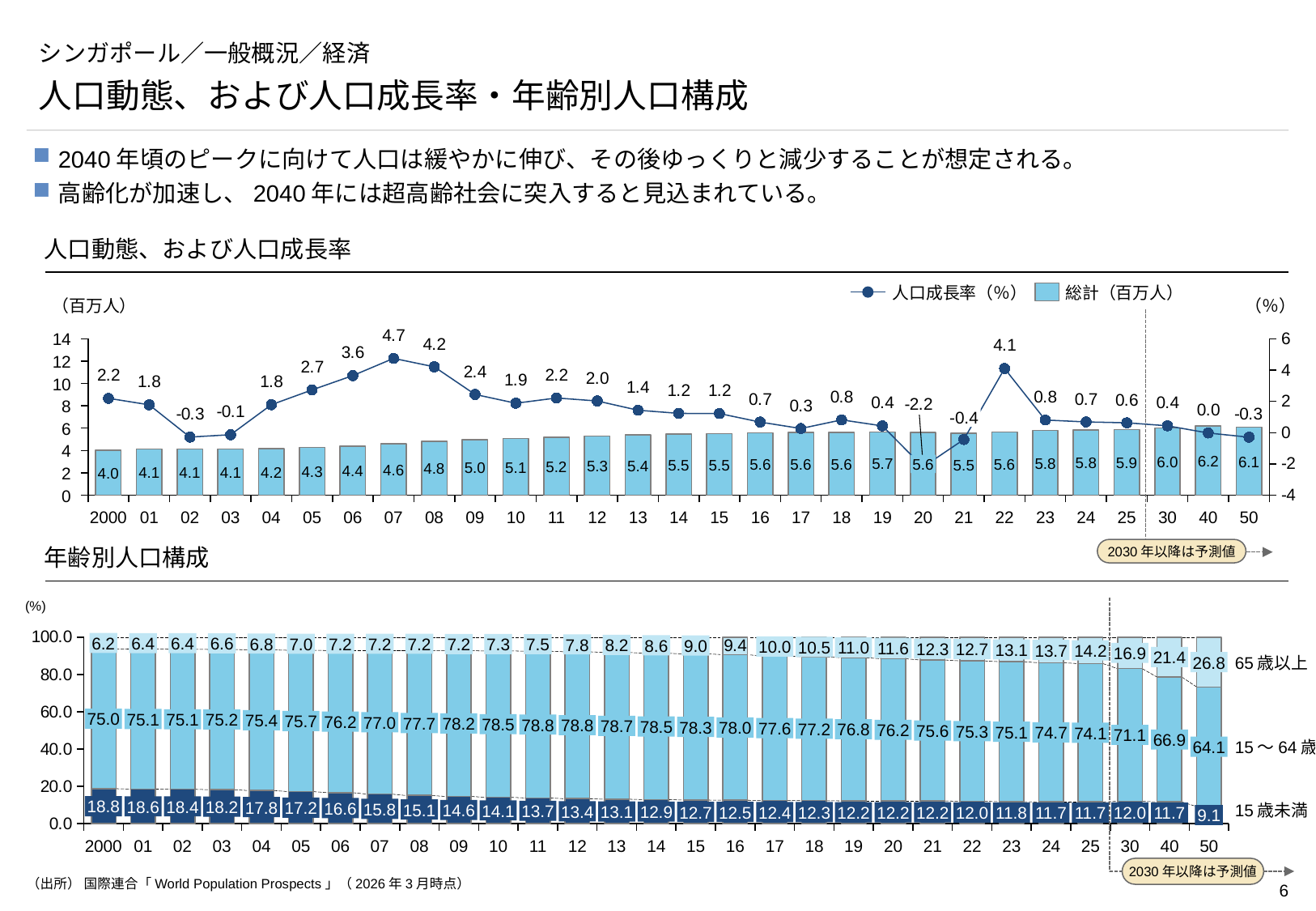
「人口動態、および人口成長率」のグラフで、2040年の総計（百万人）はいくつですか？ 6.2 「年齢別人口構成」のグラフで、15～64歳の割合が最も高い年はどれですか？ 2011年と2012年 「人口動態、および人口成長率」のグラフで、人口成長率が最も高い年はどれですか？ 2007年 「人口動態、および人口成長率」のグラフで、人口成長率が最も低い年はどれですか？ 2020年 「年齢別人口構成」のグラフで、65歳以上の割合は2000年から2050年にかけて増加していますか、減少していますか？ 増加 「人口動態、および人口成長率」のグラフで、2007年の人口成長率（%）はいくつですか？ 4.7 「年齢別人口構成」のグラフで、2050年の65歳以上と15歳未満では、どちらの割合が大きいですか？ 65歳以上 「年齢別人口構成」のグラフで、2050年の65歳以上の割合はいくつですか？ 26.8 「人口動態、および人口成長率」のグラフで、2050年の総計と2000年の総計の差は何百万人ですか？ 2.1 「年齢別人口構成」のグラフはどのような種類のグラフですか？ 積み上げ棒グラフ 「年齢別人口構成」のグラフで、2000年の15歳未満の割合はいくつですか？ 18.8 「人口動態、および人口成長率」のグラフの凭例には、いくつの系列がありますか？ 2